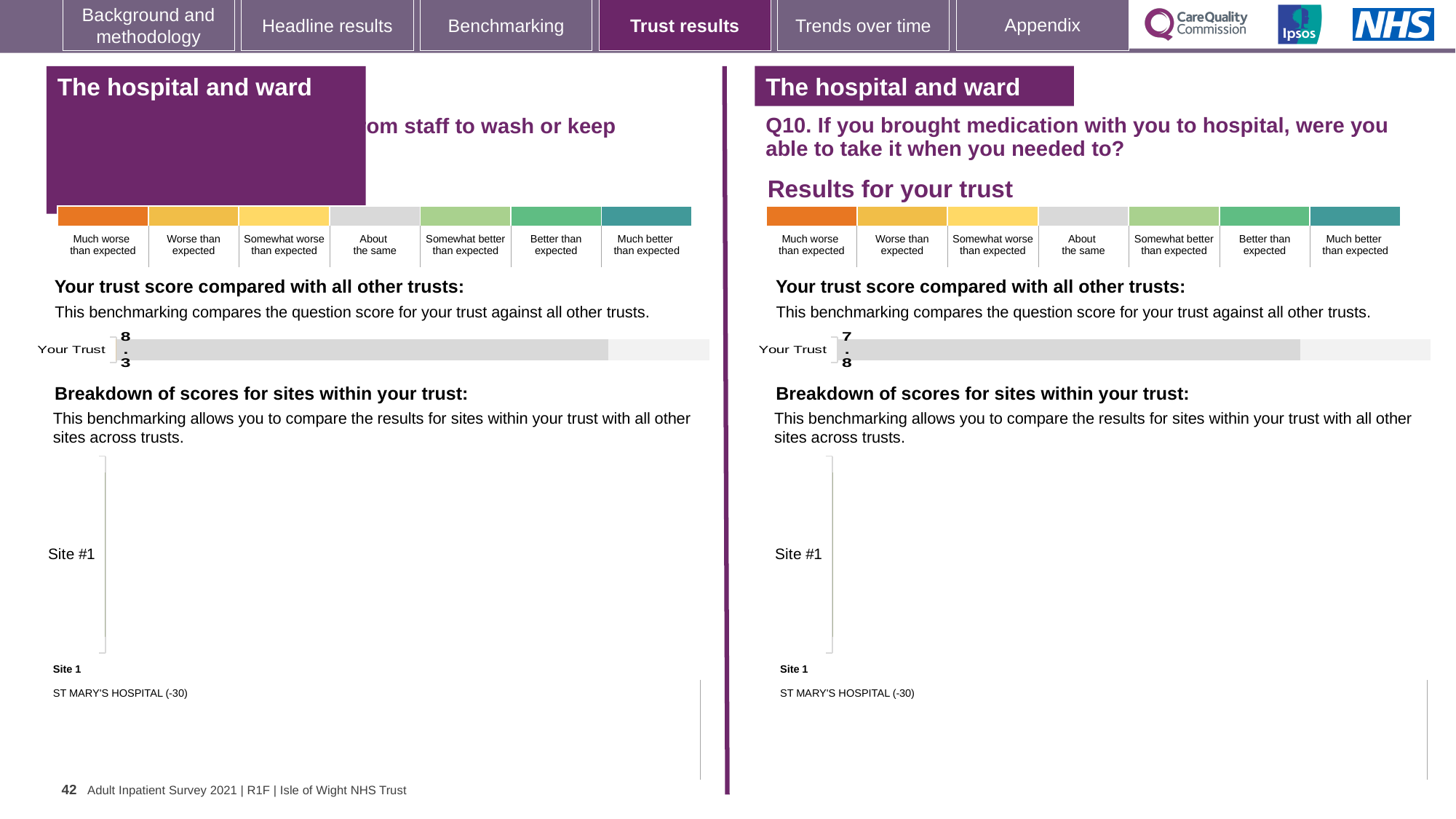
On the chart on the left side of the slide, what is the score shown for Your Trust? 8.3 How many rating bands are shown in the colour scale above the Q10 chart on the right? 7 Is the Your Trust score on the Q10 chart on the right greater or less than 8? less What kind of chart is used to show the Your Trust score on the Q10 chart on the right? Bar chart Is the Your Trust score on the chart on the left greater or less than 8? greater What is the difference between the Your Trust score on the left chart and the Your Trust score on the Q10 chart on the right? 0.5 On the Q10 chart on the right, what is the name of the site listed under Site 1? ST MARY'S HOSPITAL (-30) Which chart shows the higher Your Trust score, the one on the left or the Q10 chart on the right? The chart on the left On the Q10 chart on the right side of the slide, what is the score shown for Your Trust? 7.8 How many categories are plotted in the 'Your trust score compared with all other trusts' chart on the right side of the slide? 1